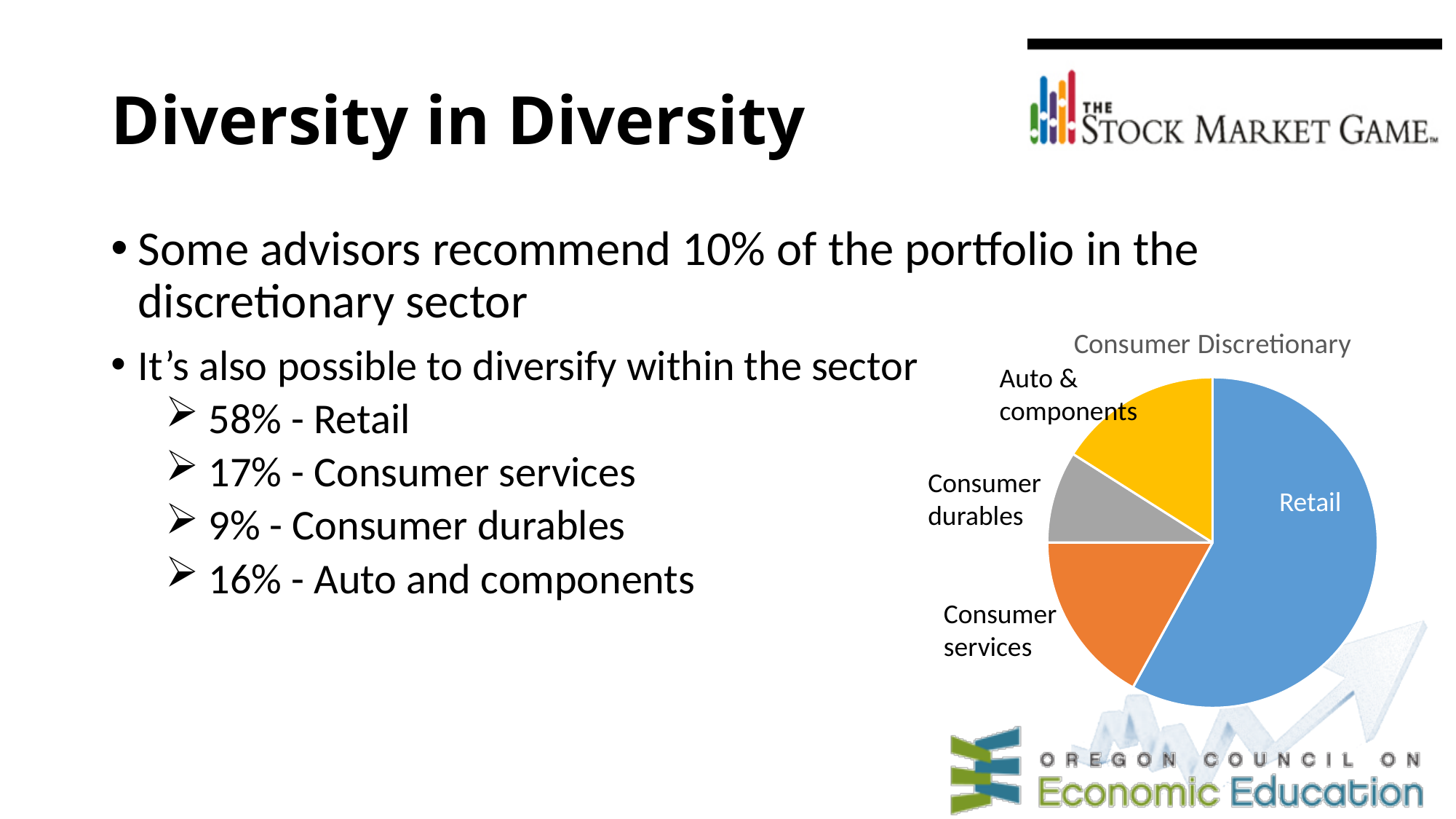
Which slice of the pie chart is the largest? Retail What kind of chart is shown on the slide? pie chart Which slice is larger in the pie chart, Consumer services or Consumer durables? Consumer services What colour is the Retail slice in the pie chart? blue What share of the Consumer Discretionary pie does Retail represent? 58% Which slice of the pie chart is the smallest? Consumer durables How many slices does the pie chart have? 4 Which slice is larger in the pie chart, Retail or Consumer services? Retail What share of the Consumer Discretionary pie does Consumer durables represent? 9% What share of the Consumer Discretionary pie does Auto & components represent? 16% What is the title of the pie chart? Consumer Discretionary What is the difference between the Retail share and the Consumer services share in the pie chart? 41%